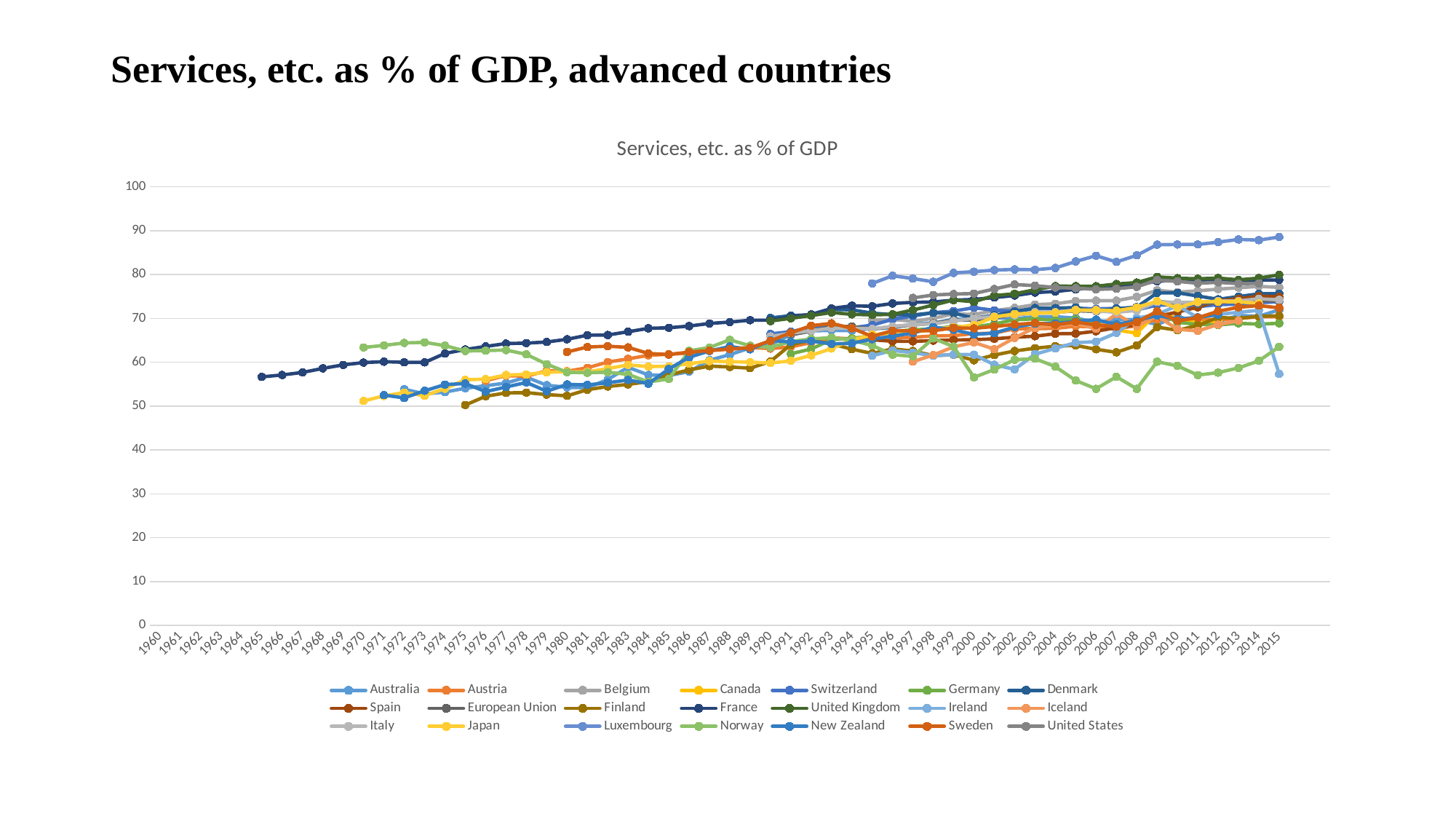
Which is larger in 2015, the value for Luxembourg or the value for Norway? Luxembourg How many series does the legend list? 21 What kind of chart is shown on the slide? line chart Which country has the highest value in 2015? Luxembourg Is the value for Norway in 2006 greater or less than 60? less What is the highest value labelled on the y axis? 100 Is the value for Luxembourg in 1995 greater or less than 70? greater Is the value for France in 1965 greater or less than 60? less How many years are labelled along the x axis? 56 Does the Luxembourg series generally rise or fall from 1995 to 2015? rise What is the title shown inside the chart area? Services, etc. as % of GDP